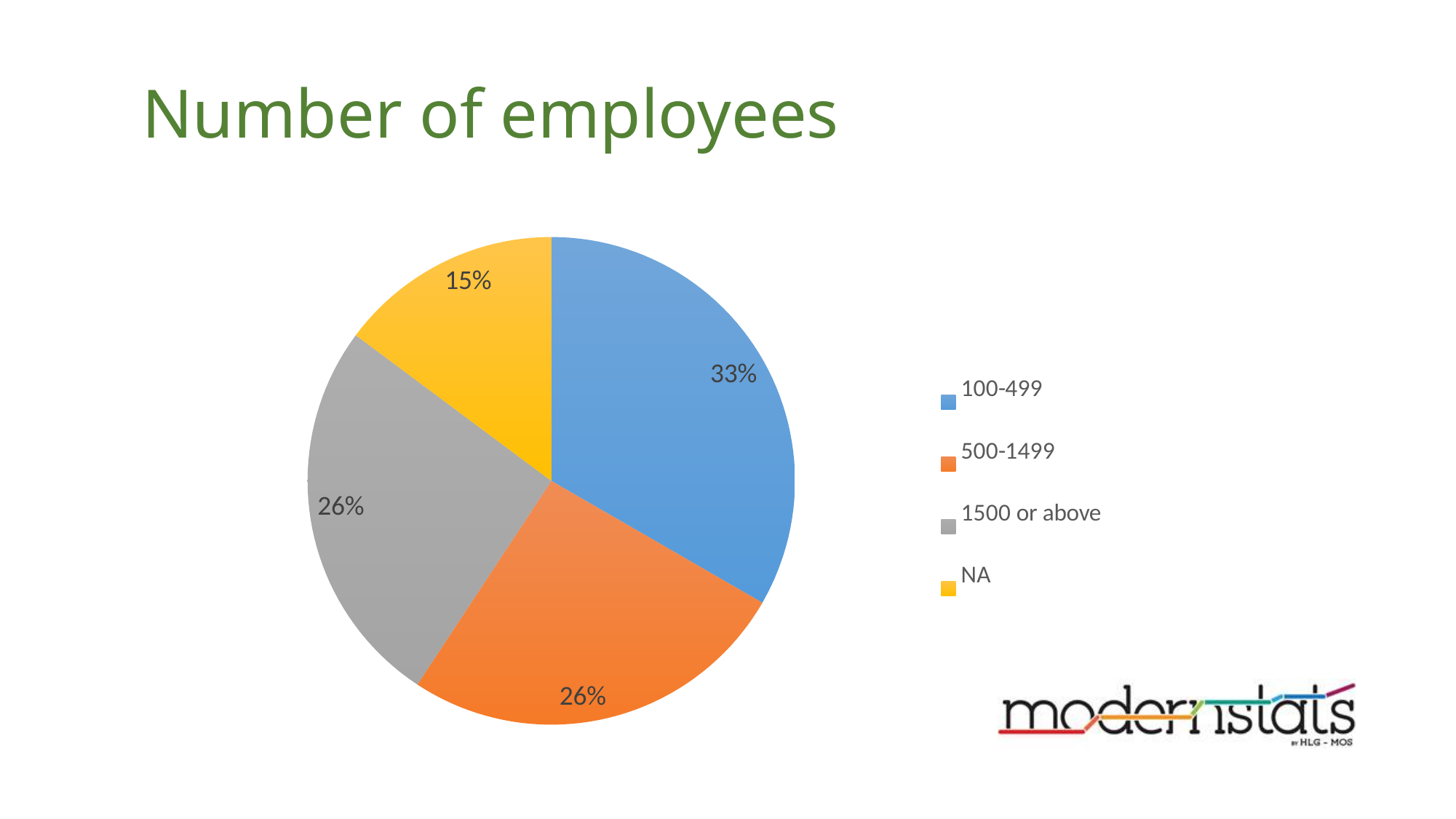
Which category has the smallest share of the pie? NA What share of the pie does the 100-499 category have? 33% What colour is the slice for the NA category? yellow Which category has the largest share of the pie? 100-499 How many categories does the pie chart have? 4 What is the title of the chart? Number of employees What is the difference in percentage points between the 100-499 share and the NA share? 18 What share of the pie does the 1500 or above category have? 26% What share of the pie does the NA category have? 15% What kind of chart is shown on the slide? pie chart Which is larger, the share for 100-499 or the share for 500-1499? 100-499